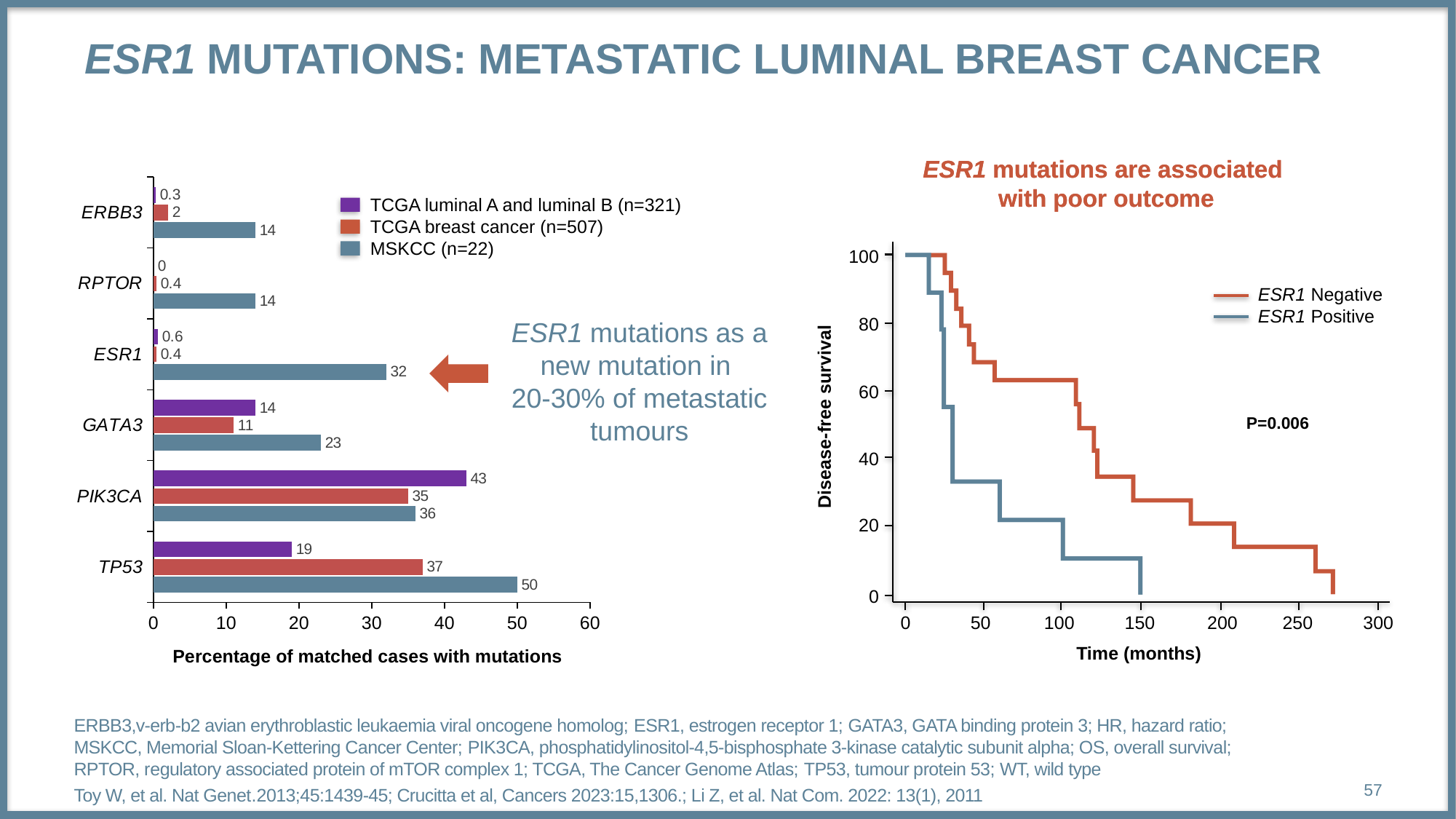
In the bar chart on the left, which is larger for PIK3CA: the TCGA breast cancer (n=507) value or the MSKCC (n=22) value? MSKCC (n=22) In the survival chart on the right, is the disease-free survival for ESR1 Positive at 50 months greater or less than 40? less What is the x-axis title of the bar chart on the left? Percentage of matched cases with mutations In the bar chart on the left, what is the difference between the MSKCC (n=22) value and the TCGA breast cancer (n=507) value for GATA3? 12 How many genes are shown in the bar chart on the left? 6 In the bar chart on the left, which gene has the lowest TCGA luminal A and luminal B (n=321) value? RPTOR In the survival chart on the right, what P value is shown? P=0.006 In the bar chart on the left, what is the MSKCC (n=22) value for ESR1? 32 In the bar chart on the left, which gene has the highest MSKCC (n=22) value? TP53 In the bar chart on the left, what is the TCGA luminal A and luminal B (n=321) value for PIK3CA? 43 In the bar chart on the left, what is the TCGA breast cancer (n=507) value for TP53? 37 How many series does the legend of the bar chart on the left list? 3